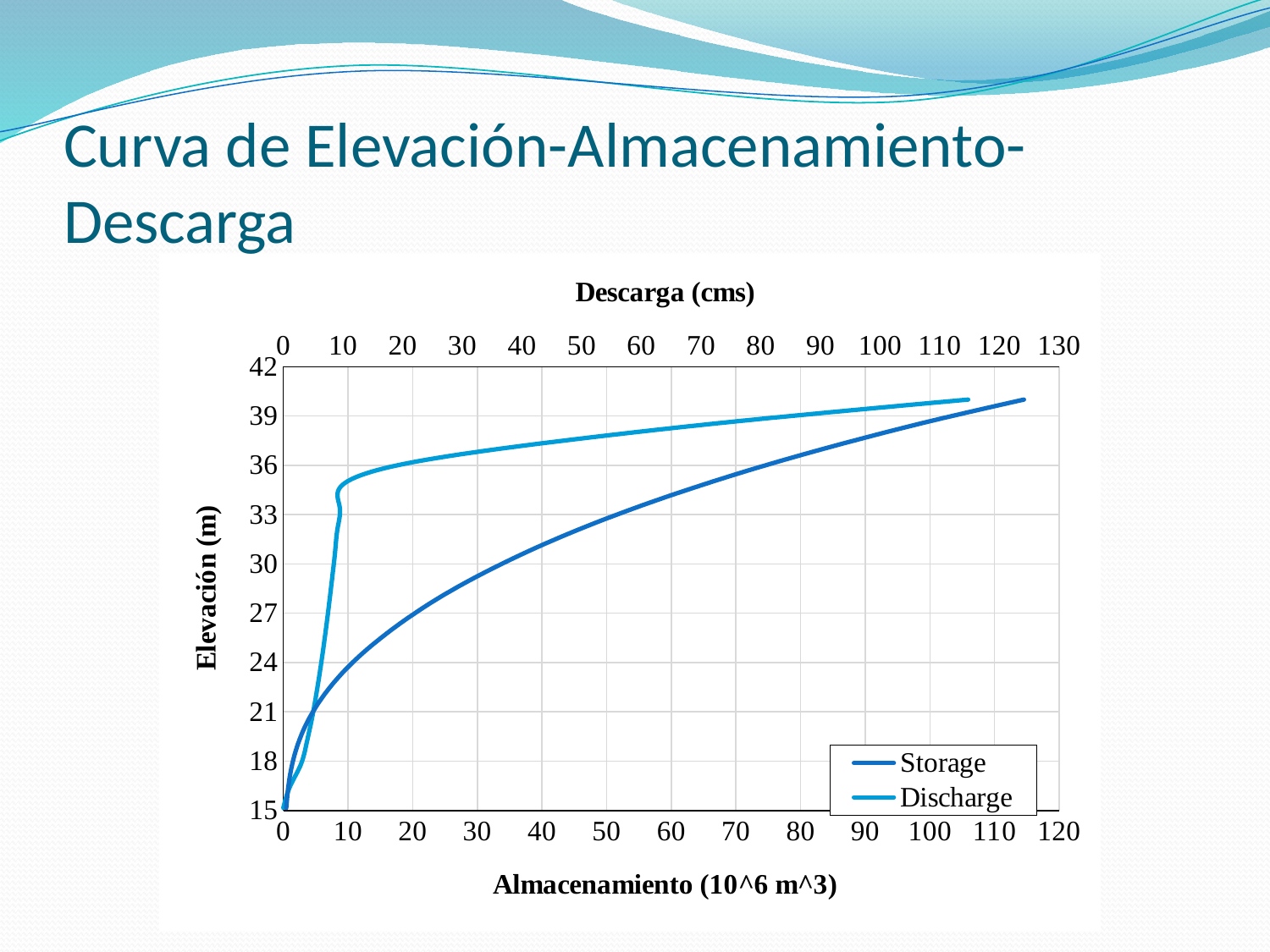
What is the title of the vertical axis? Elevación (m) What kind of chart is shown on the slide? line chart What are the two series named in the legend? Storage and Discharge Is the storage value (bottom axis) at the top end of the Storage curve greater or less than 100? greater Is the storage value (bottom axis) of the Storage curve at an elevation of 27 m greater or less than 30? less Does the Discharge curve rise or fall as discharge (Descarga) increases along the top axis? rise Is the discharge value (top axis) of the Discharge curve at an elevation of 36 m greater or less than 30? less How many series does the legend list? 2 Does the Storage curve rise or fall as storage (Almacenamiento) increases along the bottom axis? rise